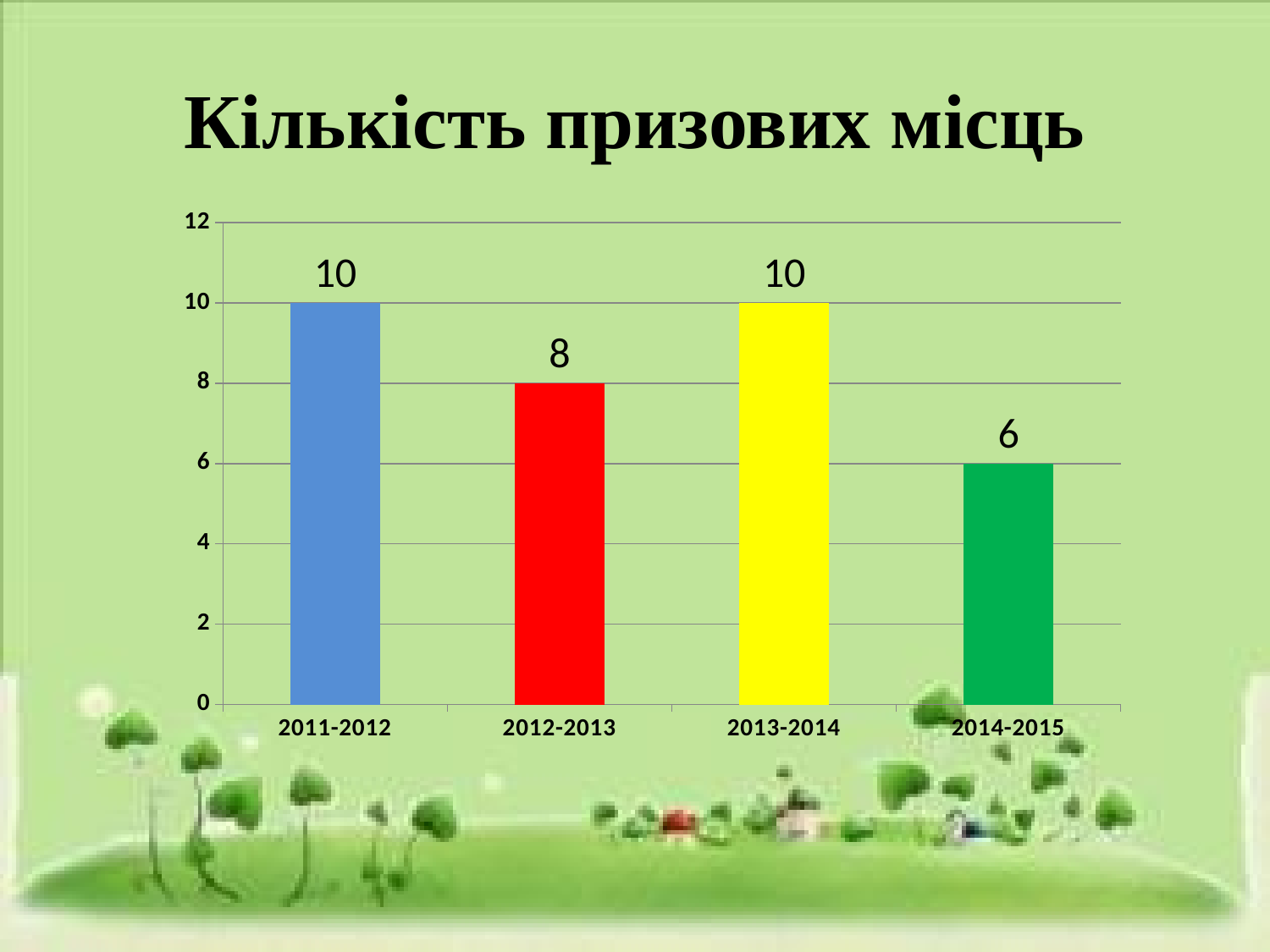
What kind of chart is shown on the slide? bar chart What is the title of the chart? Кількість призових місць What is the value for 2012-2013? 8 Which is larger, the value for 2012-2013 or the value for 2014-2015? 2012-2013 Is the value for 2012-2013 greater or less than 6? greater Which category has the lowest value? 2014-2015 What is the difference between the values for 2013-2014 and 2014-2015? 4 How many categories are shown on the x axis? 4 What is the difference between the values for 2011-2012 and 2012-2013? 2 What is the value for 2011-2012? 10 What colour is the bar for 2013-2014? yellow What is the value for 2014-2015? 6